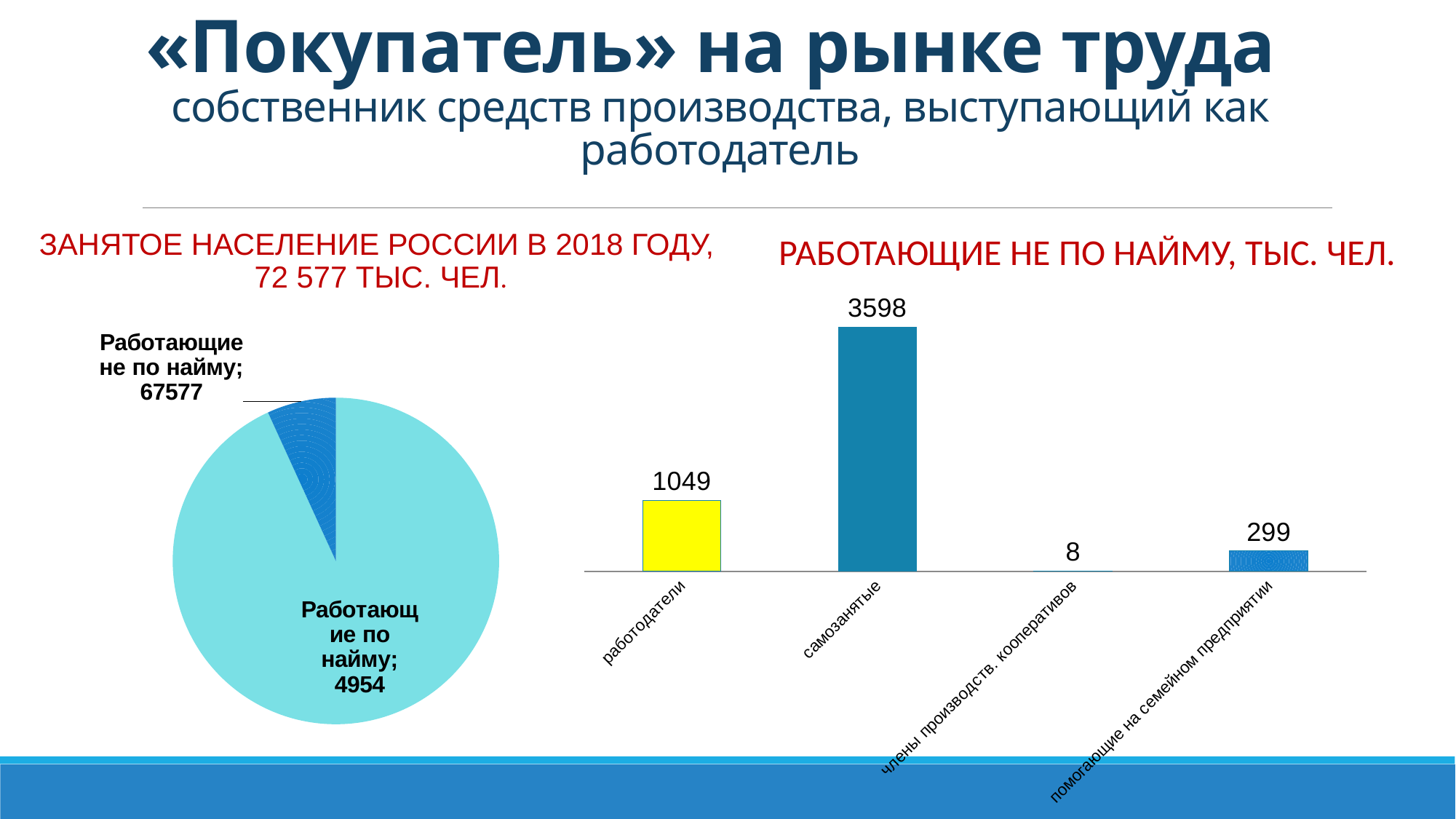
What kind of chart is the chart on the right of the slide? bar chart In the bar chart 'РАБОТАЮЩИЕ НЕ ПО НАЙМУ, ТЫС. ЧЕЛ.', which category has the lowest value? члены производств. кооперативов In the bar chart 'РАБОТАЮЩИЕ НЕ ПО НАЙМУ, ТЫС. ЧЕЛ.', what is the value for самозанятые? 3598 In the bar chart 'РАБОТАЮЩИЕ НЕ ПО НАЙМУ, ТЫС. ЧЕЛ.', which is larger: работодатели or помогающие на семейном предприятии? работодатели How many categories are shown in the bar chart 'РАБОТАЮЩИЕ НЕ ПО НАЙМУ, ТЫС. ЧЕЛ.'? 4 In the bar chart 'РАБОТАЮЩИЕ НЕ ПО НАЙМУ, ТЫС. ЧЕЛ.', which category has the highest value? самозанятые In the bar chart 'РАБОТАЮЩИЕ НЕ ПО НАЙМУ, ТЫС. ЧЕЛ.', what colour is the bar for работодатели? yellow In the bar chart 'РАБОТАЮЩИЕ НЕ ПО НАЙМУ, ТЫС. ЧЕЛ.', what is the value for работодатели? 1049 In the bar chart 'РАБОТАЮЩИЕ НЕ ПО НАЙМУ, ТЫС. ЧЕЛ.', what is the value for члены производств. кооперативов? 8 In the bar chart 'РАБОТАЮЩИЕ НЕ ПО НАЙМУ, ТЫС. ЧЕЛ.', what is the value for помогающие на семейном предприятии? 299 What kind of chart is the chart on the left of the slide, titled 'ЗАНЯТОЕ НАСЕЛЕНИЕ РОССИИ В 2018 ГОДУ, 72 577 ТЫС. ЧЕЛ.'? pie chart In the bar chart 'РАБОТАЮЩИЕ НЕ ПО НАЙМУ, ТЫС. ЧЕЛ.', what is the difference between the values for самозанятые and работодатели? 2549